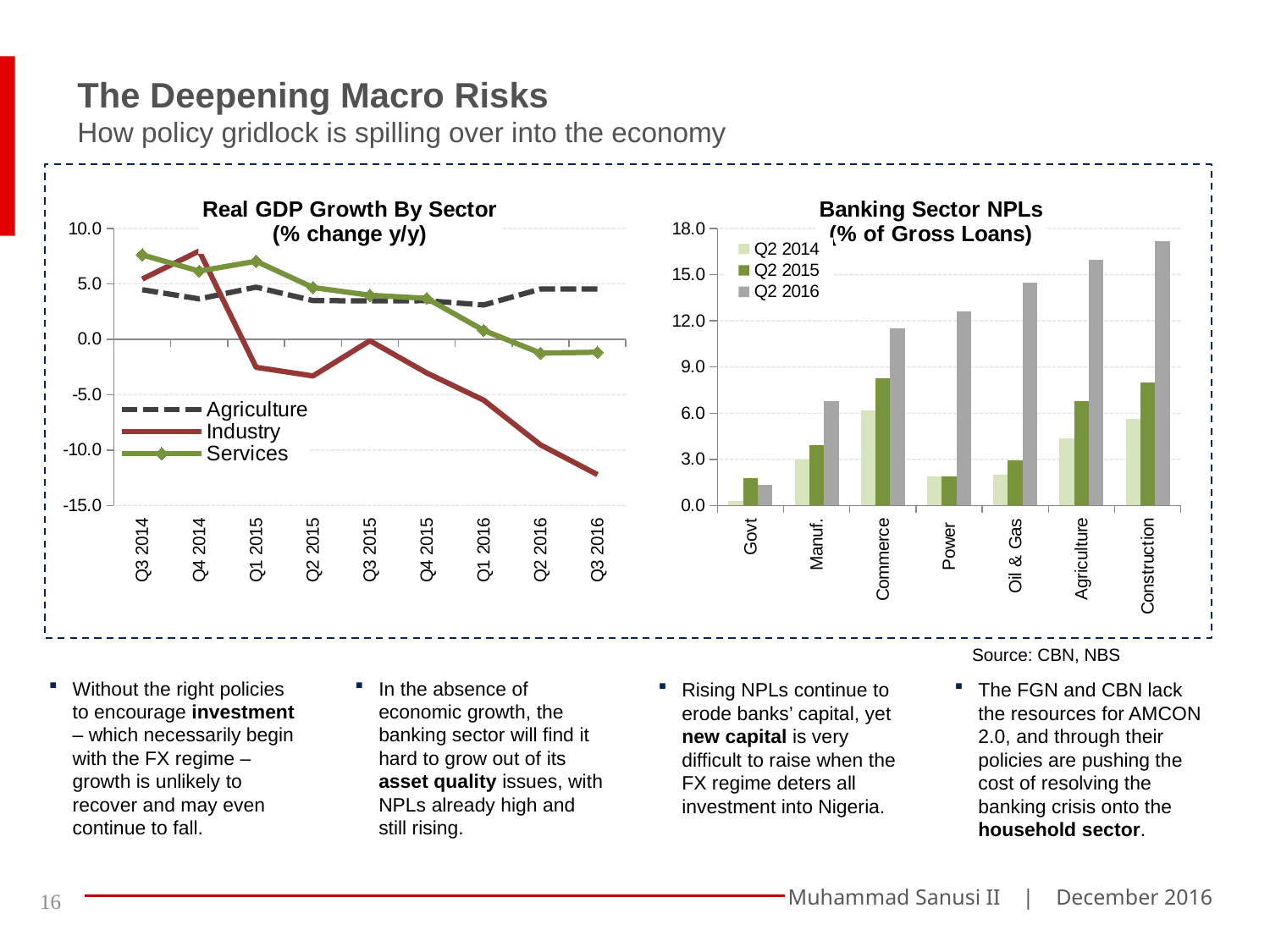
In the 'Banking Sector NPLs' chart, which sector has the lowest Q2 2016 value? Govt How many quarters are shown on the x axis of the 'Real GDP Growth By Sector' chart? 9 What kind of chart is the 'Banking Sector NPLs' chart on the right? bar chart What kind of chart is the 'Real GDP Growth By Sector' chart on the left? line chart In the 'Real GDP Growth By Sector' chart, does the Industry series rise or fall from Q3 2014 to Q3 2016? fall How many sectors are shown on the x axis of the 'Banking Sector NPLs' chart? 7 In the 'Banking Sector NPLs' chart, which sector has the highest Q2 2016 value? Construction In the 'Banking Sector NPLs' chart, is the Q2 2016 value for Oil & Gas larger or smaller than the Q2 2016 value for Commerce? larger How many series does the legend of the 'Real GDP Growth By Sector' chart list? 3 In the 'Real GDP Growth By Sector' chart, is the Services value for Q3 2014 greater or less than 5.0? greater In the 'Real GDP Growth By Sector' chart, is the Industry value for Q3 2016 greater or less than -10.0? less How many series does the legend of the 'Banking Sector NPLs' chart list? 3